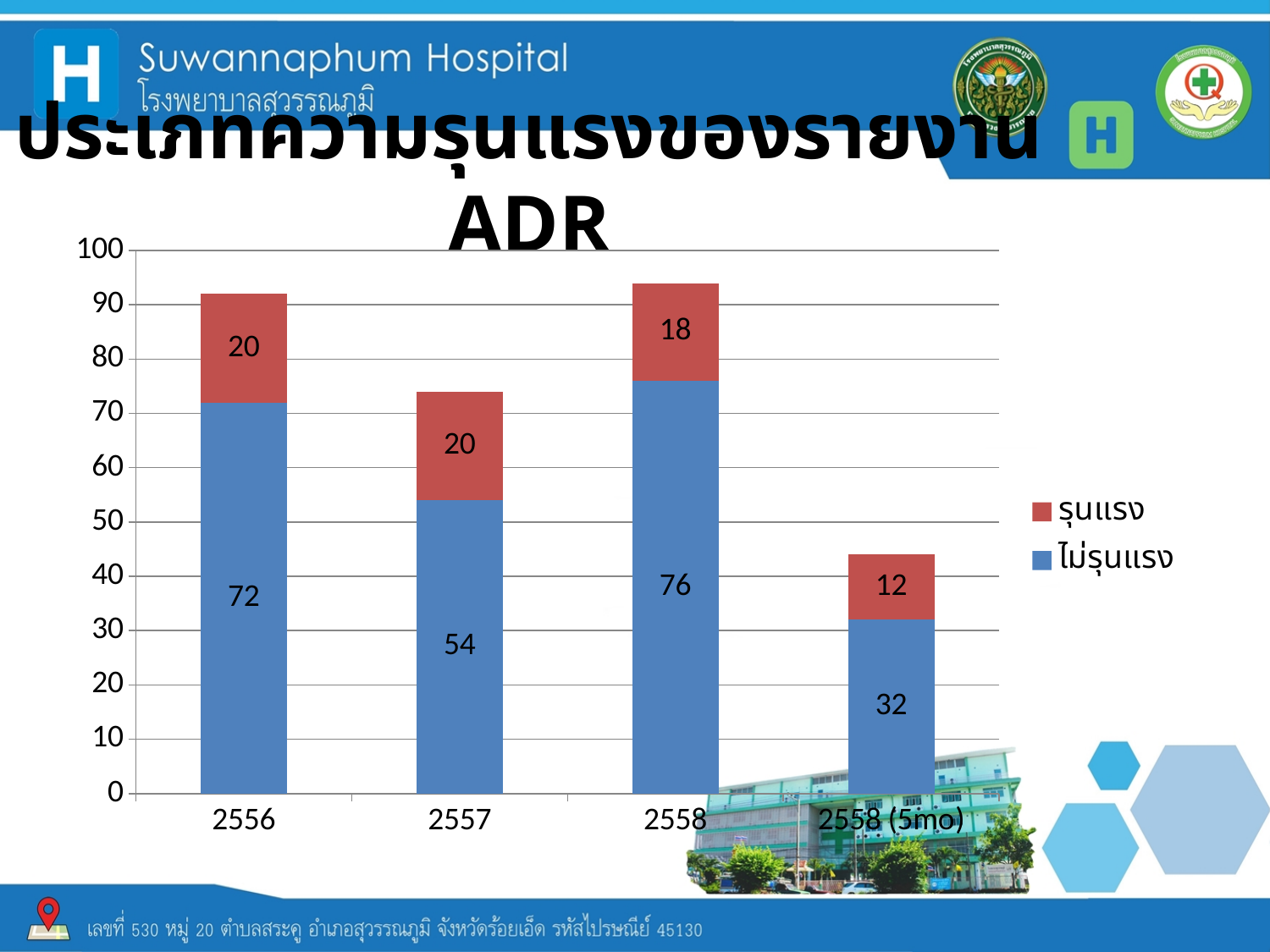
How many categories are shown on the x axis? 4 What is the value for ไม่รุนแรง in 2558 (5mo)? 32 Which is larger, the ไม่รุนแรง value for 2556 or for 2557? 2556 What is the value for รุนแรง in 2558? 18 How many series does the legend list? 2 What is the total of the stacked bar for 2558 (5mo)? 44 What is the total of the stacked bar for 2557? 74 What is the difference between the ไม่รุนแรง values for 2558 and 2557? 22 What is the value for ไม่รุนแรง in 2556? 72 Which category has the lowest value for รุนแรง? 2558 (5mo) Which year has the highest value for ไม่รุนแรง? 2558 What kind of chart is shown on the slide? Stacked bar chart